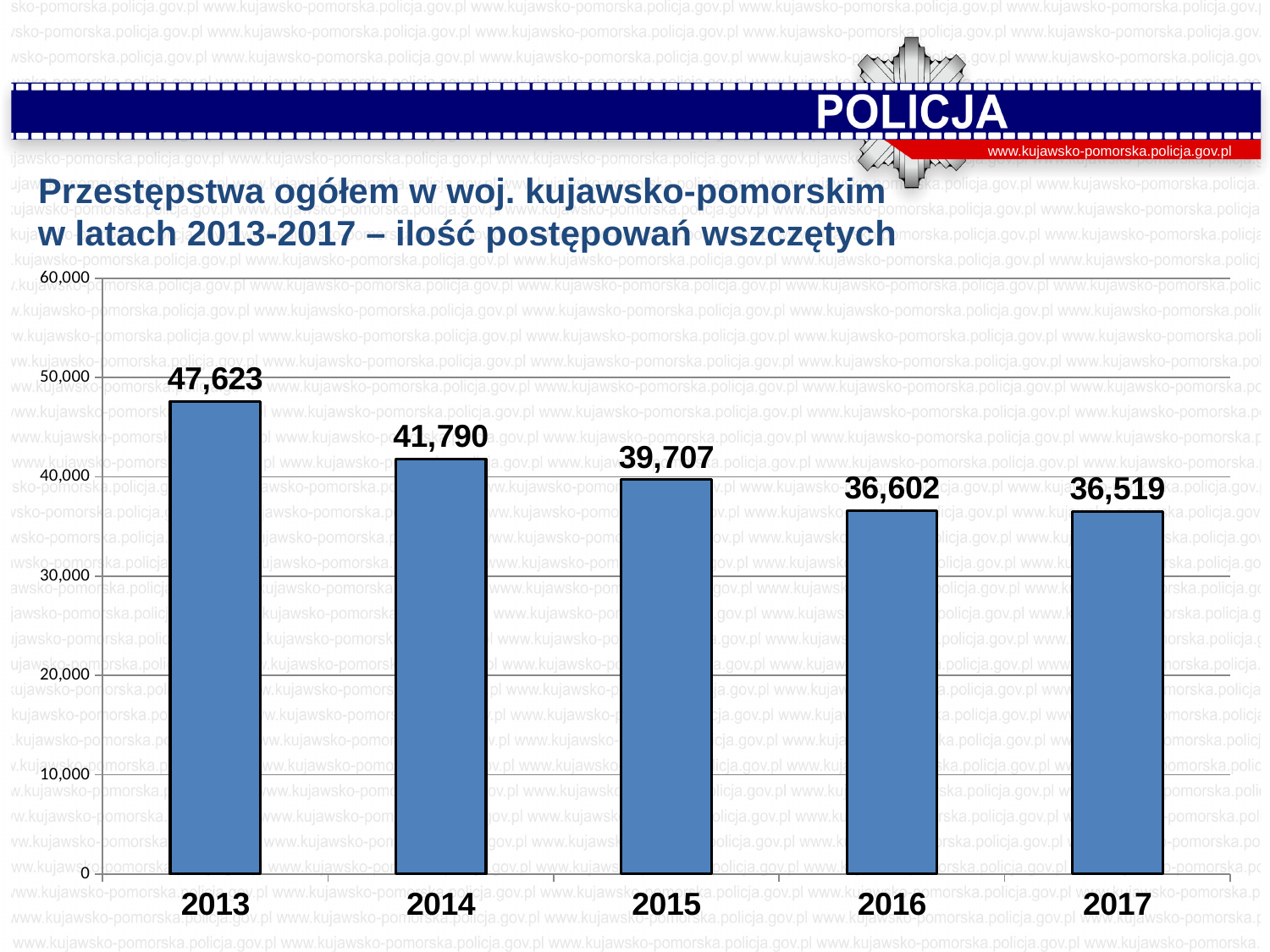
How many years are shown on the chart? 5 Which year has the lowest value? 2017 Which is larger, the value for 2014 or the value for 2015? 2014 What is the difference between the values for 2013 and 2014? 5,833 What kind of chart is shown on the slide? bar chart What is the difference between the values for 2016 and 2017? 83 Is the value for 2016 greater or less than 40,000? less What is the value for 2015? 39,707 Do the values rise or fall from 2013 to 2017? fall What is the value for 2013? 47,623 Which year has the highest value? 2013 What is the value for 2017? 36,519